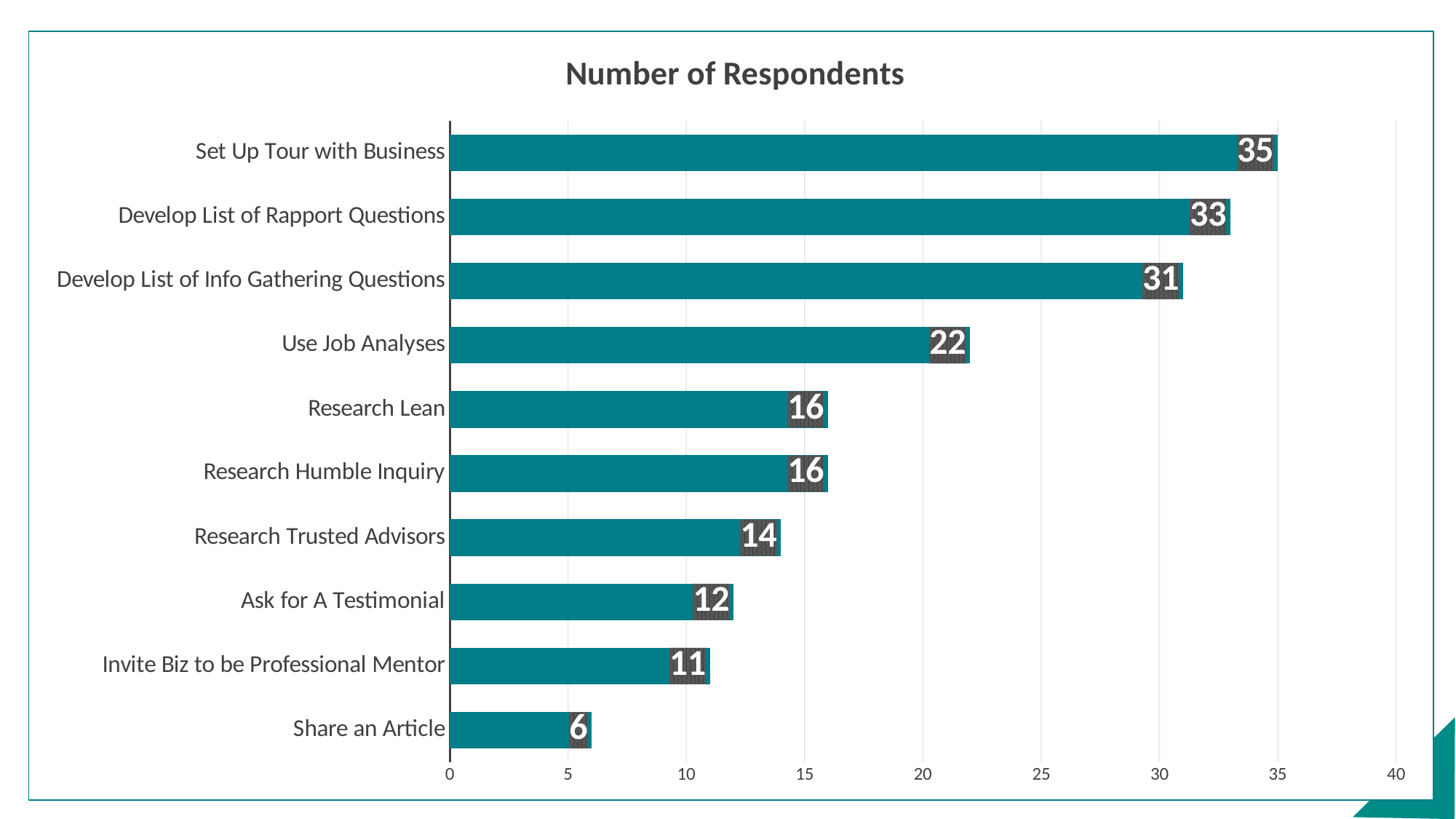
Which has more respondents, Research Trusted Advisors or Ask for A Testimonial? Research Trusted Advisors What is the difference in respondents between Use Job Analyses and Share an Article? 16 Which category has the highest number of respondents? Set Up Tour with Business Which category has the lowest number of respondents? Share an Article What is the number of respondents for Set Up Tour with Business? 35 What kind of chart is shown on the slide? Bar chart How many categories are shown in the chart? 10 Is the value for Develop List of Info Gathering Questions greater or less than 30? greater What is the difference in respondents between Develop List of Rapport Questions and Develop List of Info Gathering Questions? 2 What is the number of respondents for Use Job Analyses? 22 What is the title of the chart? Number of Respondents What is the number of respondents for Invite Biz to be Professional Mentor? 11